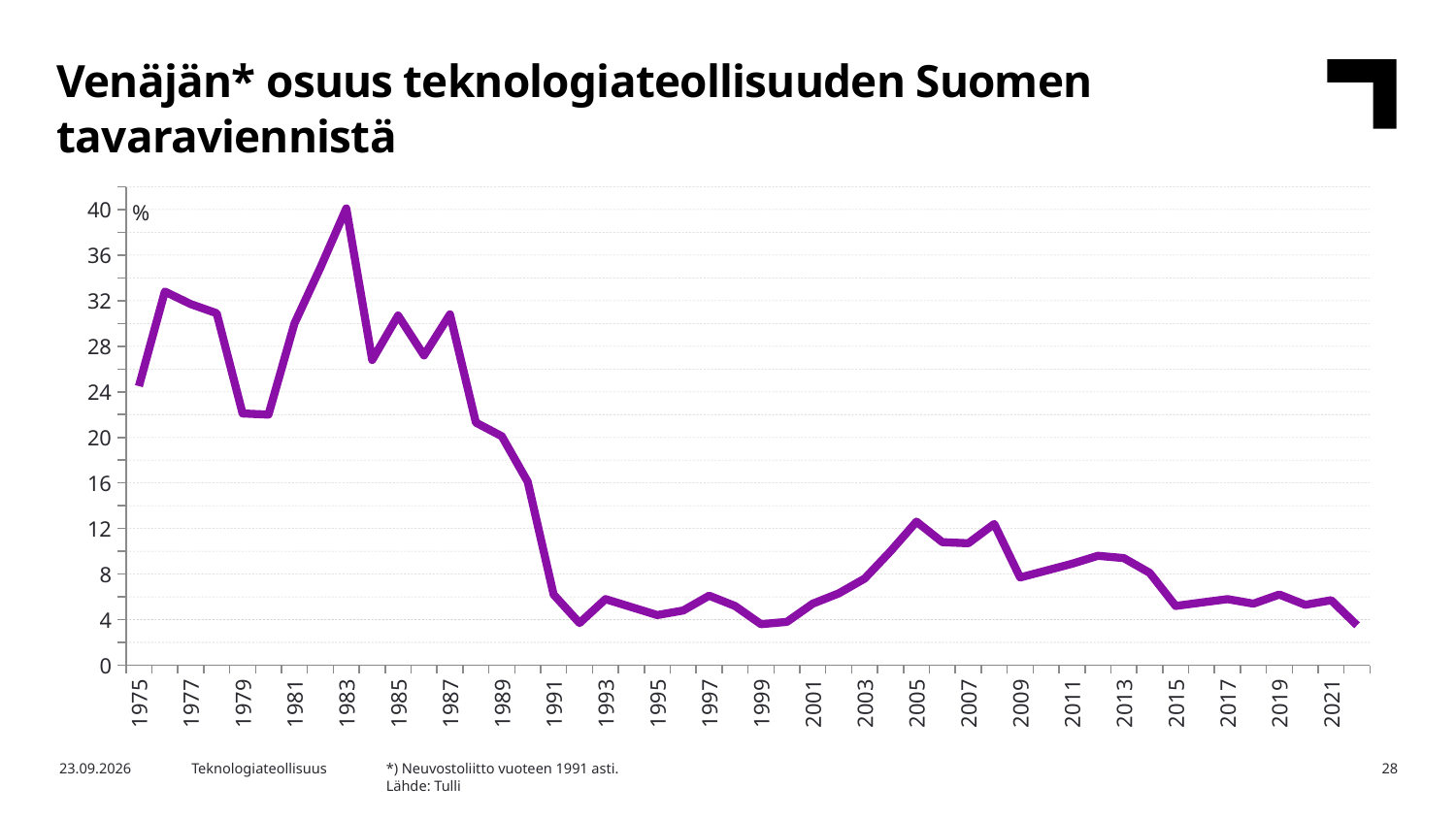
Which year has the larger value, 1977 or 1979? 1977 Is the value for 1975 greater or less than 20? greater Does the line rise or fall between 1983 and 1991? fall Which year has the larger value, 1983 or 1985? 1983 What unit is shown on the y axis of the chart? % Is the value for 1991 greater or less than 8? less Is the value for 1983 greater or less than 36? greater What kind of chart is shown on the slide? line chart What is the title of the chart? Venäjän* osuus teknologiateollisuuden Suomen tavaraviennistä In which year does the line reach its highest value? 1983